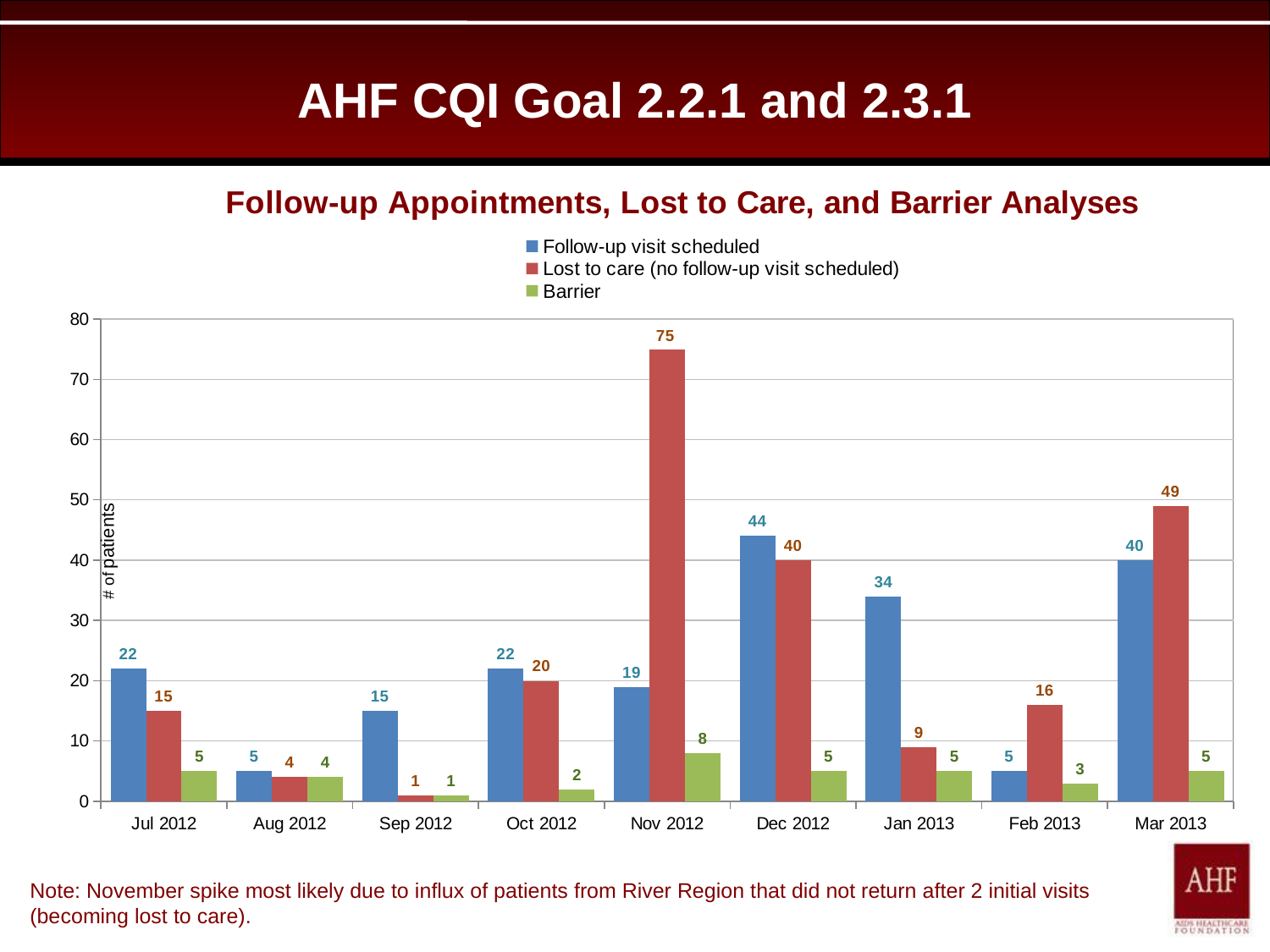
What is the value for Lost to care (no follow-up visit scheduled) in Nov 2012? 75 What is the value for Follow-up visit scheduled in Dec 2012? 44 What is the difference between Lost to care and Follow-up visit scheduled in Mar 2013? 9 What is the label of the y axis? # of patients In Jan 2013, which is larger: Follow-up visit scheduled or Lost to care (no follow-up visit scheduled)? Follow-up visit scheduled Which month has the highest value for Follow-up visit scheduled? Dec 2012 What is the difference between the Follow-up visit scheduled values for Jul 2012 and Aug 2012? 17 Which month has the lowest value for Lost to care (no follow-up visit scheduled)? Sep 2012 What kind of chart is shown on the slide? Bar chart How many months are shown on the x axis? 9 What is the Barrier value for Nov 2012? 8 How many series does the legend list? 3